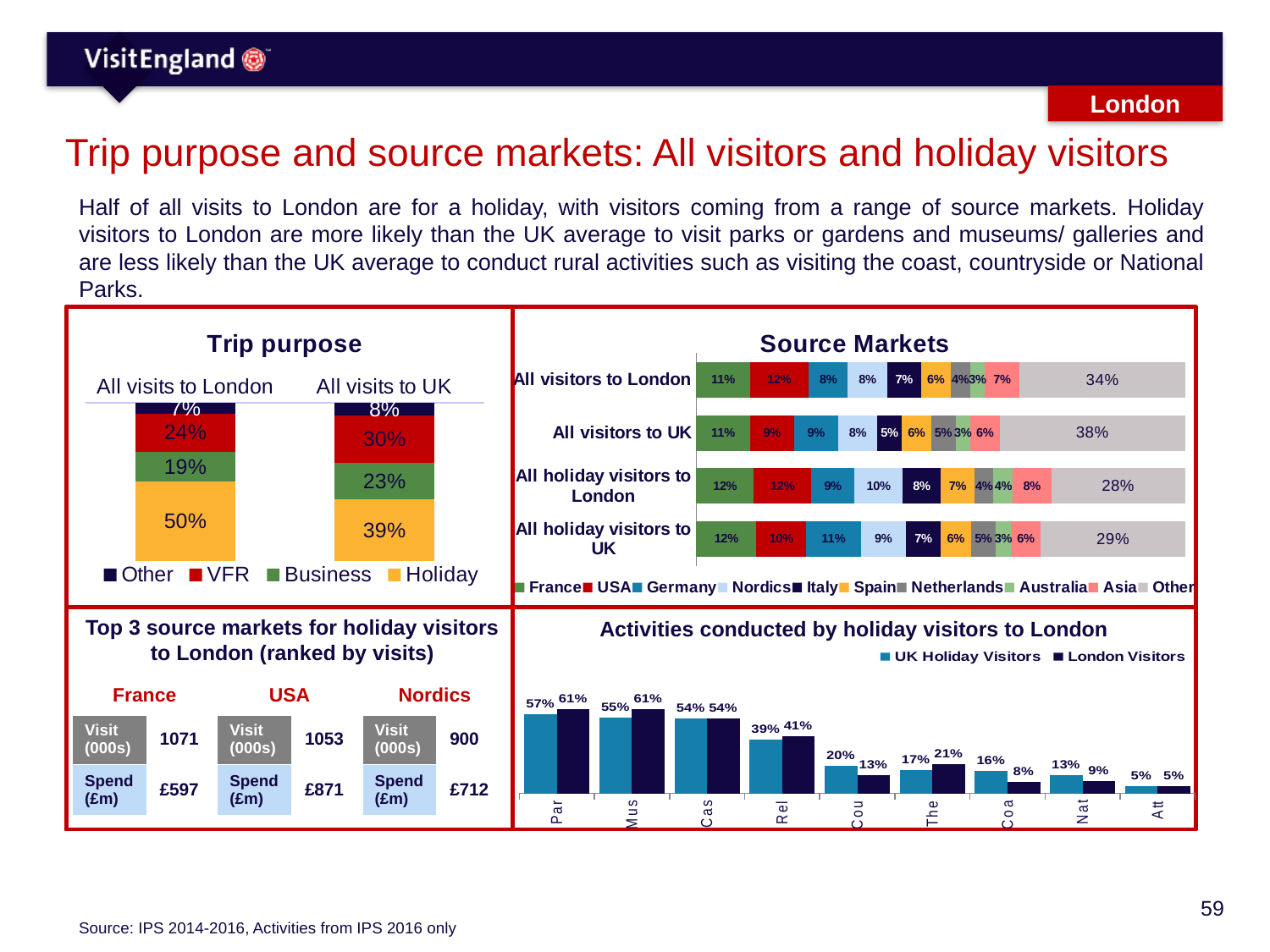
In the Source Markets chart, what is the 'Other' share for all visitors to the UK? 38% How many series does the legend of the Trip purpose chart list? 4 What kind of chart is the Activities conducted by holiday visitors to London chart? Bar chart In the Trip purpose chart, what is the difference between the Holiday share for all visits to London and for all visits to the UK? 11 percentage points In the Trip purpose chart, which segment is the largest for all visits to London? Holiday In the Trip purpose chart, what share of all visits to London are for a holiday? 50% In the Source Markets chart, which is larger: the Germany share for all holiday visitors to the UK or the Germany share for all holiday visitors to London? All holiday visitors to UK In the Trip purpose chart, what is the Business share for all visits to the UK? 23% In the Source Markets chart, what is the Nordics share for all holiday visitors to London? 10% In the Activities conducted by holiday visitors to London chart, what is the London Visitors value for the first category (labelled 'Par')? 61% In the Source Markets chart, what share of all visitors to London come from the USA? 12% How many series does the legend of the Source Markets chart list? 10